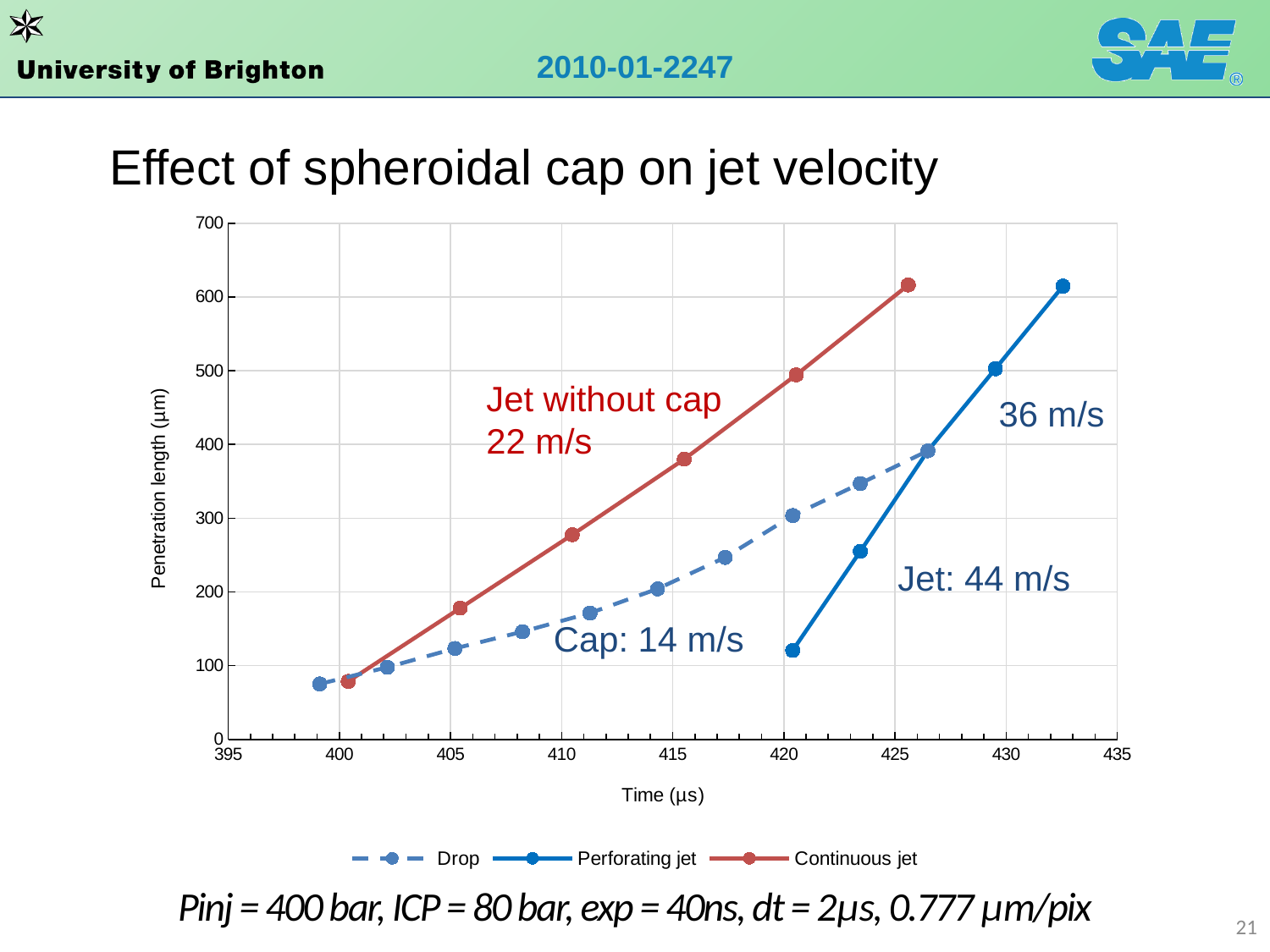
Does the penetration length of the Drop series rise or fall as time increases? rise What is the label of the y axis? Penetration length (µm) Is the first Perforating jet point (near 420 µs) greater or less than 100 µm? greater How many series does the legend list? 3 How many data points are plotted for the Perforating jet series? 5 Does the penetration length of the Continuous jet rise or fall as time increases? rise Which series are listed in the legend? Drop, Perforating jet, Continuous jet What velocity is annotated for the jet without cap? 22 m/s At about 420 µs, which series has the greater penetration length, Continuous jet or Drop? Continuous jet What kind of chart is shown on the slide? line chart Is the Continuous jet value near 415 µs greater or less than 400 µm? less